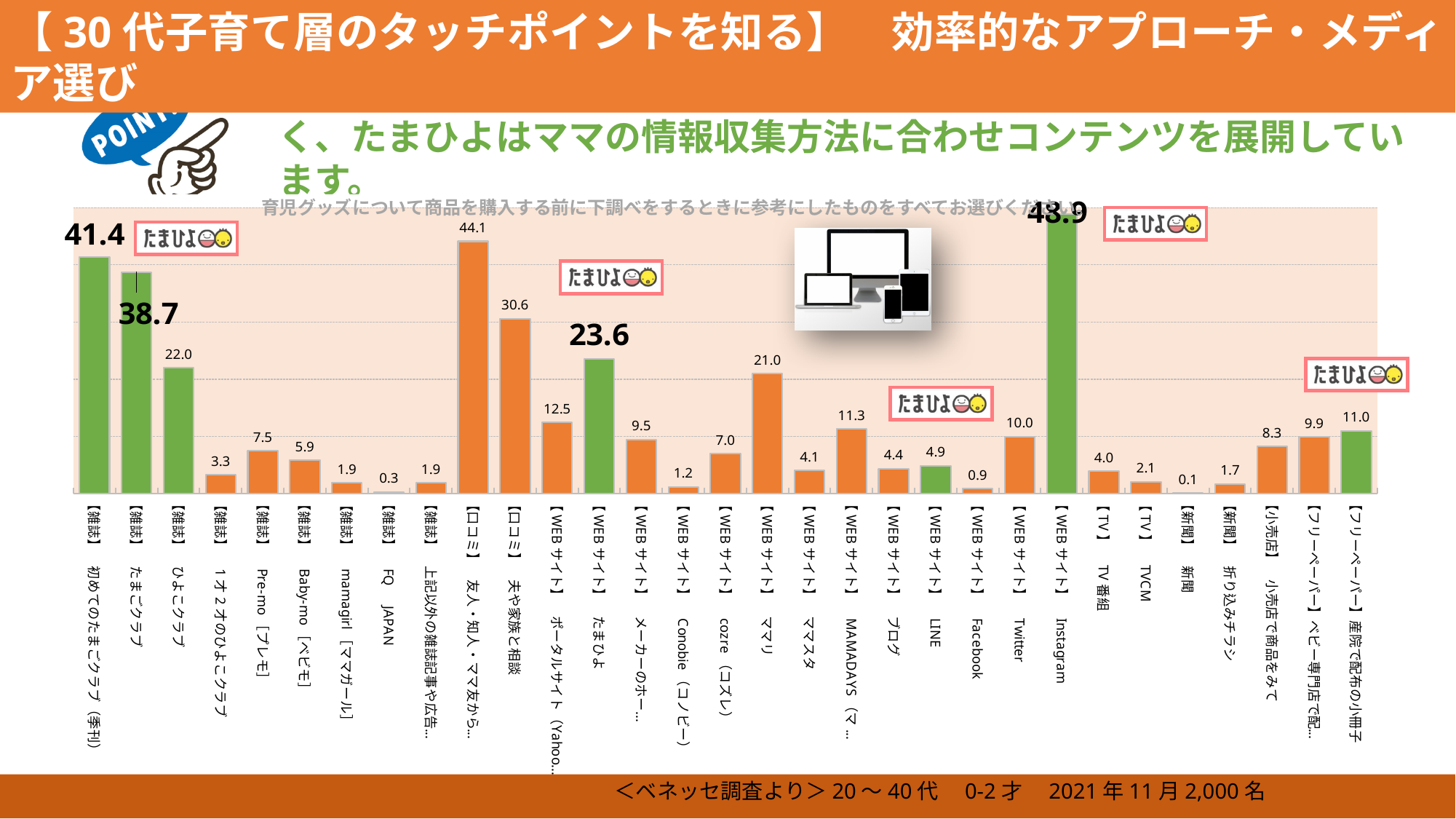
Which is larger, 【TV】TV番組 or 【TV】TVCM? 【TV】TV番組 What is the value for 【口コミ】友人・知人・ママ友から? 44.1 What is the difference between 【WEBサイト】Twitter and 【WEBサイト】Facebook? 9.1 What kind of chart is shown on the slide? Bar chart Which is larger, 【WEBサイト】たまひよ or 【WEBサイト】ポータルサイト? 【WEBサイト】たまひよ What is the value for 【WEBサイト】Instagram? 48.9 What is the difference between 【雑誌】初めてのたまごクラブ（季刊） and 【雑誌】ひよこクラブ? 19.4 What is the value for 【雑誌】たまごクラブ? 38.7 Which category has the highest value? 【WEBサイト】Instagram How many categories are shown in the chart? 31 What is the value for 【WEBサイト】ママリ? 21.0 Which category has the lowest value? 【新聞】新聞